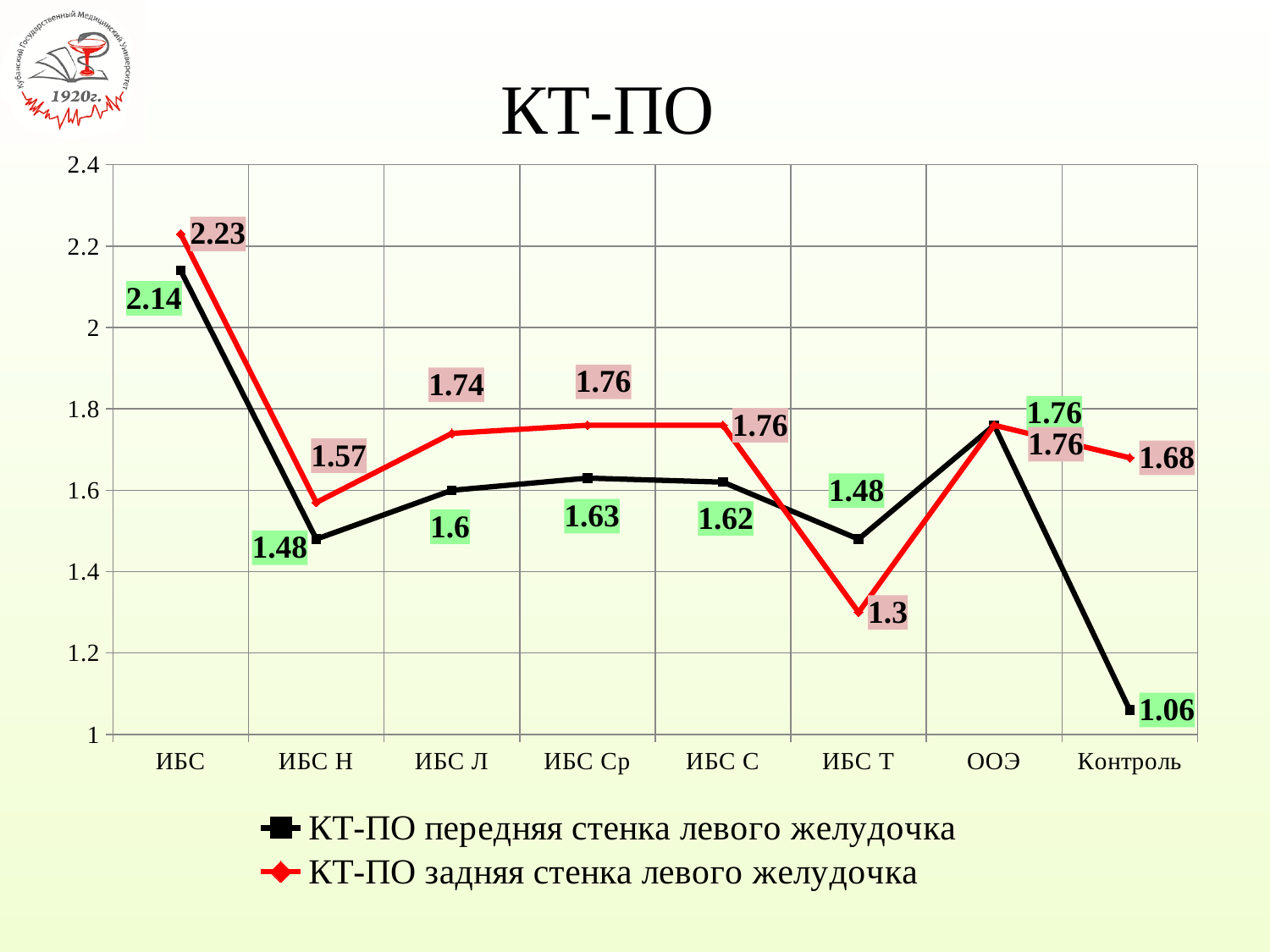
What type of chart is shown on the slide? line chart Is the value of КТ-ПО задняя стенка левого желудочка for ИБС Н greater or less than 1.6? less What is the value of КТ-ПО передняя стенка левого желудочка for Контроль? 1.06 What is the value of КТ-ПО передняя стенка левого желудочка for ИБС? 2.14 How many categories are shown on the x axis? 8 What is the difference between the two series for Контроль? 0.62 Which category has the lowest value for КТ-ПО передняя стенка левого желудочка? Контроль How many series does the legend list? 2 What is the value of КТ-ПО задняя стенка левого желудочка for ИБС Т? 1.3 What is the title of the chart? КТ-ПО For ИБС Т, which series has the larger value: передняя стенка or задняя стенка? КТ-ПО передняя стенка левого желудочка Which category has the highest value for КТ-ПО задняя стенка левого желудочка? ИБС